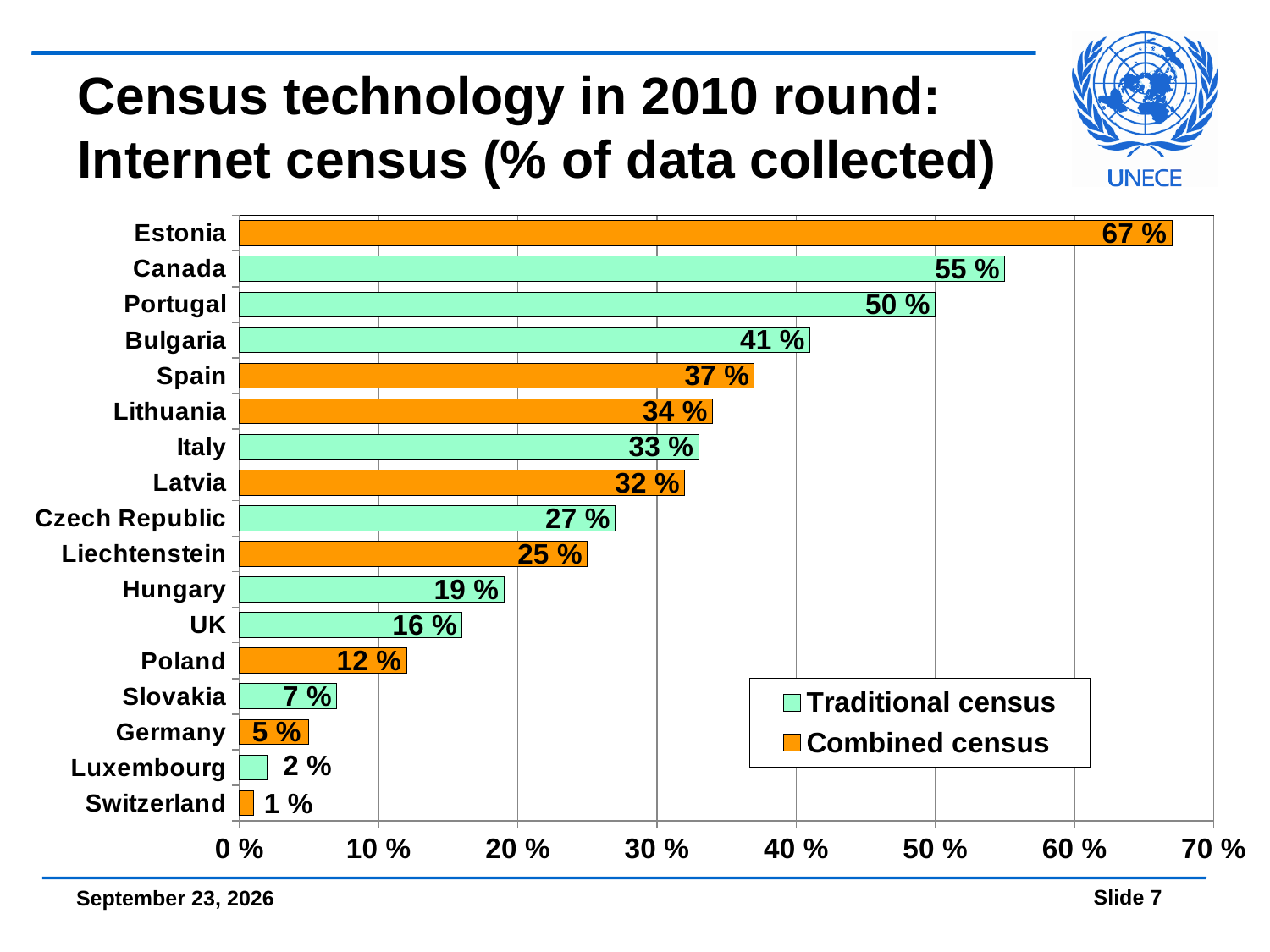
Which country has the lowest value? Switzerland Which country has the highest value? Estonia What kind of chart is shown on the slide? Bar chart Which has a larger value, Spain or Lithuania? Spain What is the value for Poland? 12 % What is the difference between the values for Canada and Portugal? 5 % How many countries are shown in the chart? 17 What is the value for Czech Republic? 27 % What is the value for Estonia? 67 % Which series does the Bulgaria bar belong to? Traditional census What colour are the Combined census bars? Orange How many series does the legend list? 2